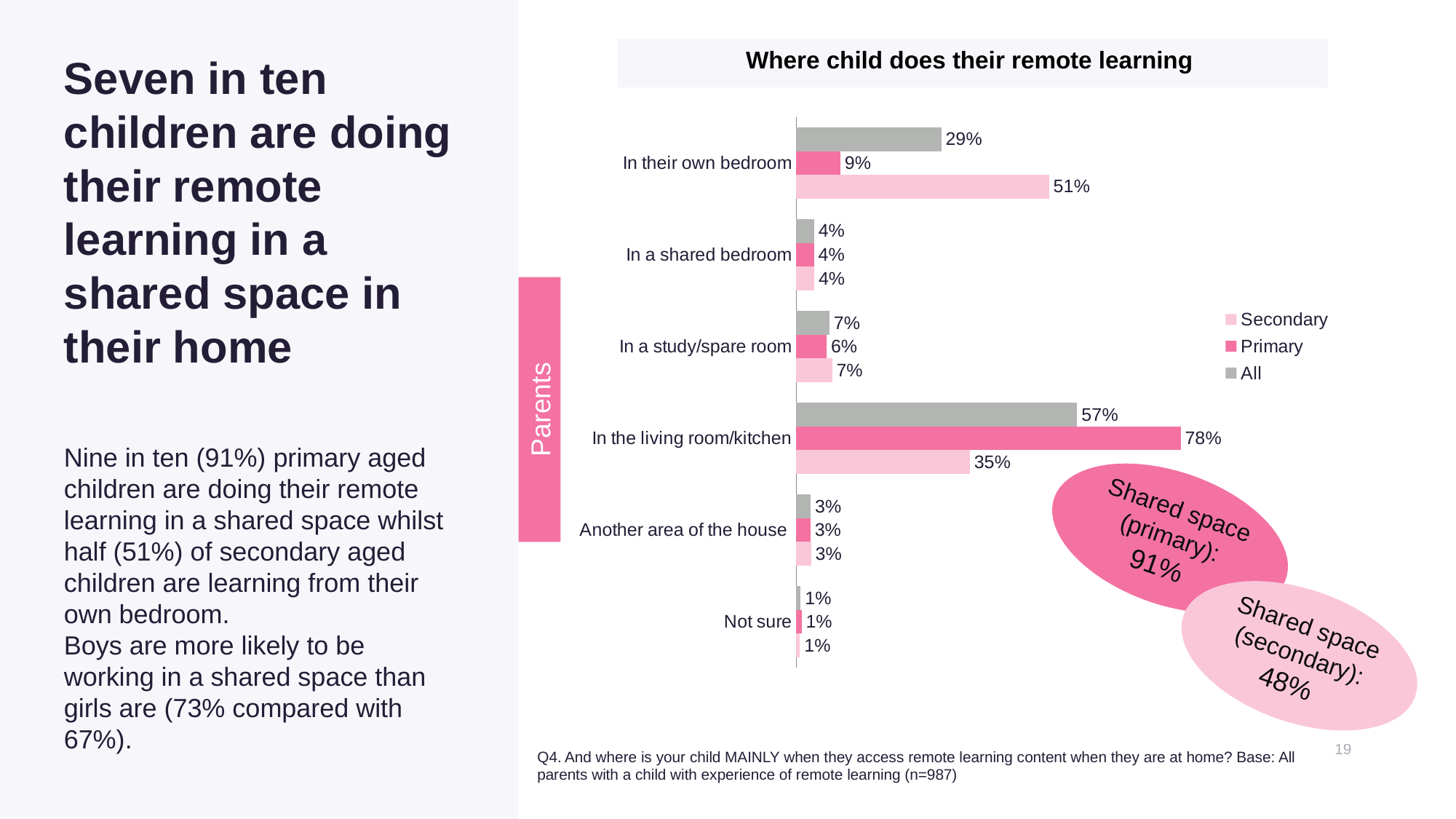
Which location has the lowest value for the All series? Not sure What type of chart is used to show where children do their remote learning? Bar chart What is the difference between the Primary and Secondary values for the living room/kitchen? 43% How many series does the legend list? 3 Which location has the highest value for the Secondary series? In their own bedroom What percentage of primary aged children do their remote learning in the living room/kitchen? 78% What is the title of the chart? Where child does their remote learning How many location categories are shown on the chart? 6 What is the difference between the Secondary and Primary values for 'In their own bedroom'? 42% Which is larger for 'In a study/spare room': the All value or the Primary value? All What is the value for All children doing remote learning in their own bedroom? 29% What percentage of secondary aged children do their remote learning in their own bedroom? 51%